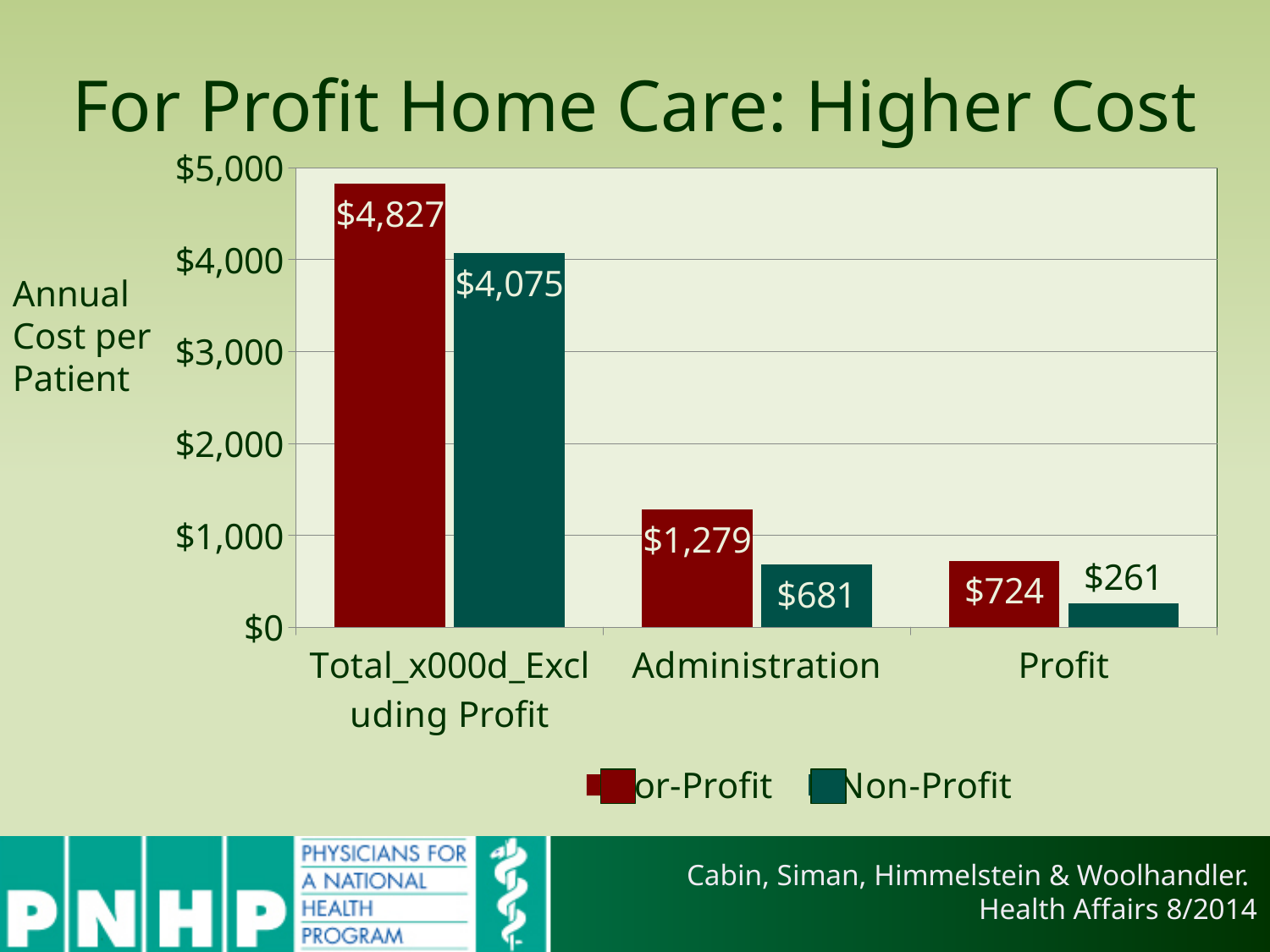
How many categories are shown on the x axis? 3 What is the Non-Profit value for the Profit category? $261 What is the For-Profit (red) value for Administration? $1,279 What is the difference between the For-Profit and Non-Profit values for Administration? $598 How many series does the legend list? 2 Which category has the highest For-Profit (red) value? Total Excluding Profit What is the difference between the For-Profit and Non-Profit values for Total Excluding Profit? $752 What is the For-Profit (red) value for the Profit category? $724 Which bar has the lowest value on the chart? Non-Profit, Profit ($261) For the Profit category, which is larger: the For-Profit (red) value or the Non-Profit value? For-Profit What kind of chart is shown on the slide? Bar chart What is the Non-Profit value for the Total Excluding Profit category? $4,075